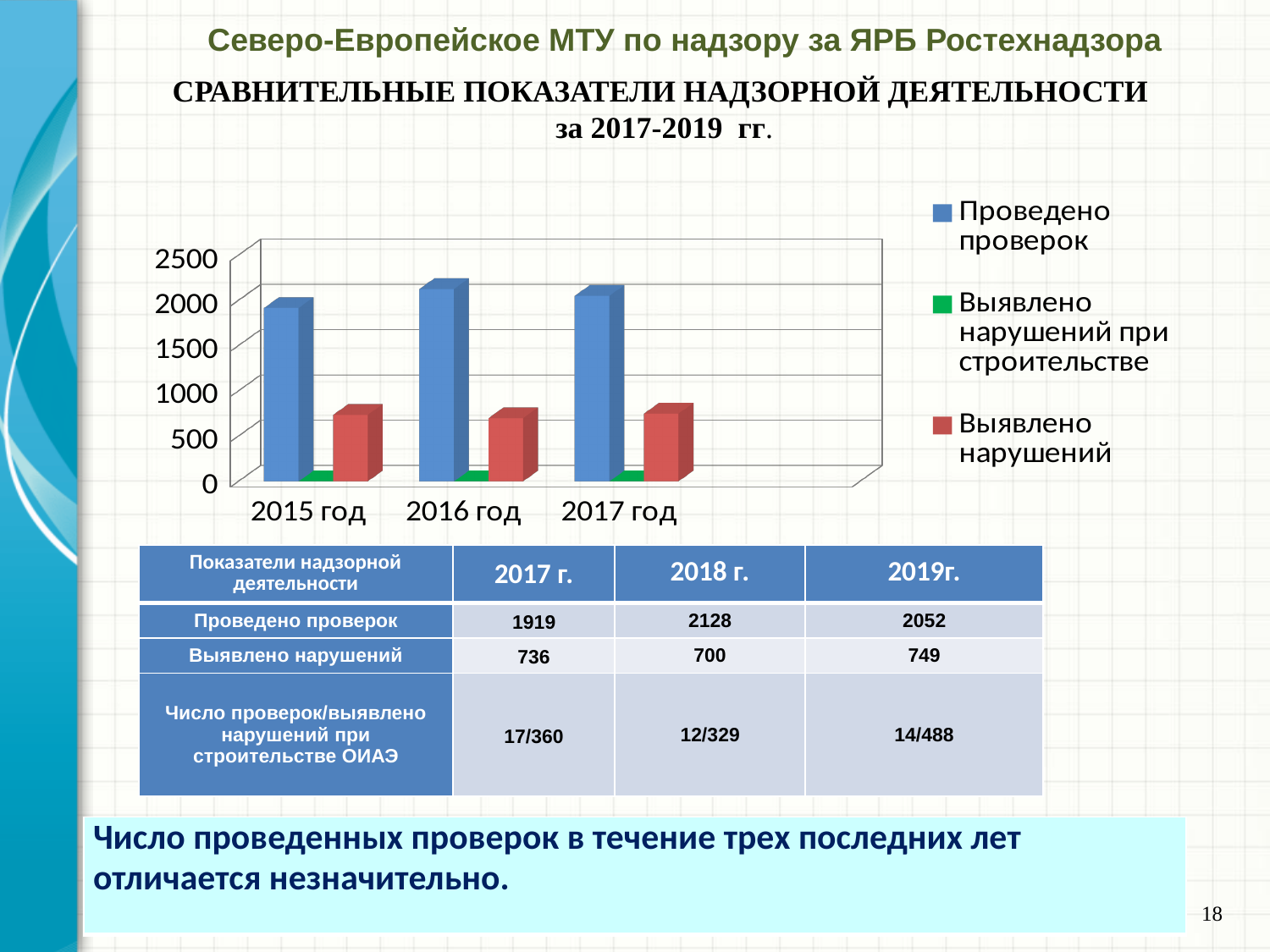
Which is larger in 2017 год: "Проведено проверок" or "Выявлено нарушений"? Проведено проверок What colour represents the "Проведено проверок" series in the chart? blue How many series does the chart legend list? 3 Is the value for "Выявлено нарушений при строительстве" in 2016 год greater or less than 500? less Does the value for "Проведено проверок" rise or fall from 2015 год to 2016 год? rise Which year has the highest value for "Проведено проверок"? 2016 год Is the value for "Проведено проверок" in 2016 год greater or less than 2000? greater How many year categories are shown on the x axis of the chart? 3 Which year has the lowest value for "Проведено проверок"? 2015 год Is the value for "Выявлено нарушений" in 2015 год greater or less than 500? greater What kind of chart is shown on the slide? bar chart